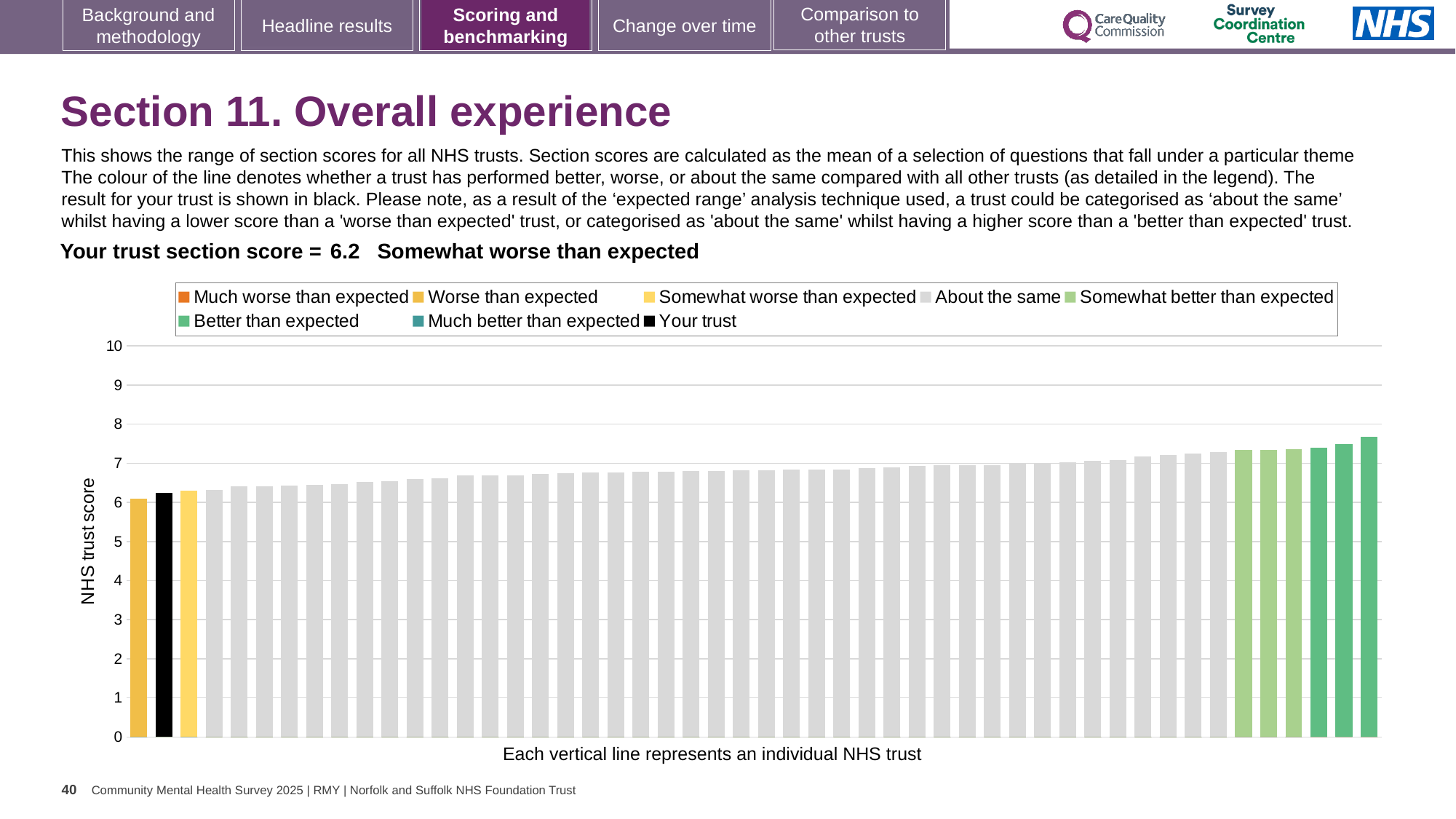
Do the bar values rise or fall from left to right along the x axis? rise Which benchmarking category is your trust placed in for Section 11? Somewhat worse than expected What colour is the bar representing your trust? Black What is the section score for your trust shown on the slide? 6.2 What kind of chart is shown on the slide? Bar chart Is the value for your trust (the black bar) greater or less than 7? less How many entries does the chart legend list? 8 Is the value of the tallest bar in the chart greater or less than 8? less What is the title of the vertical axis? NHS trust score Is the value of the tallest bar in the chart greater or less than 7? greater